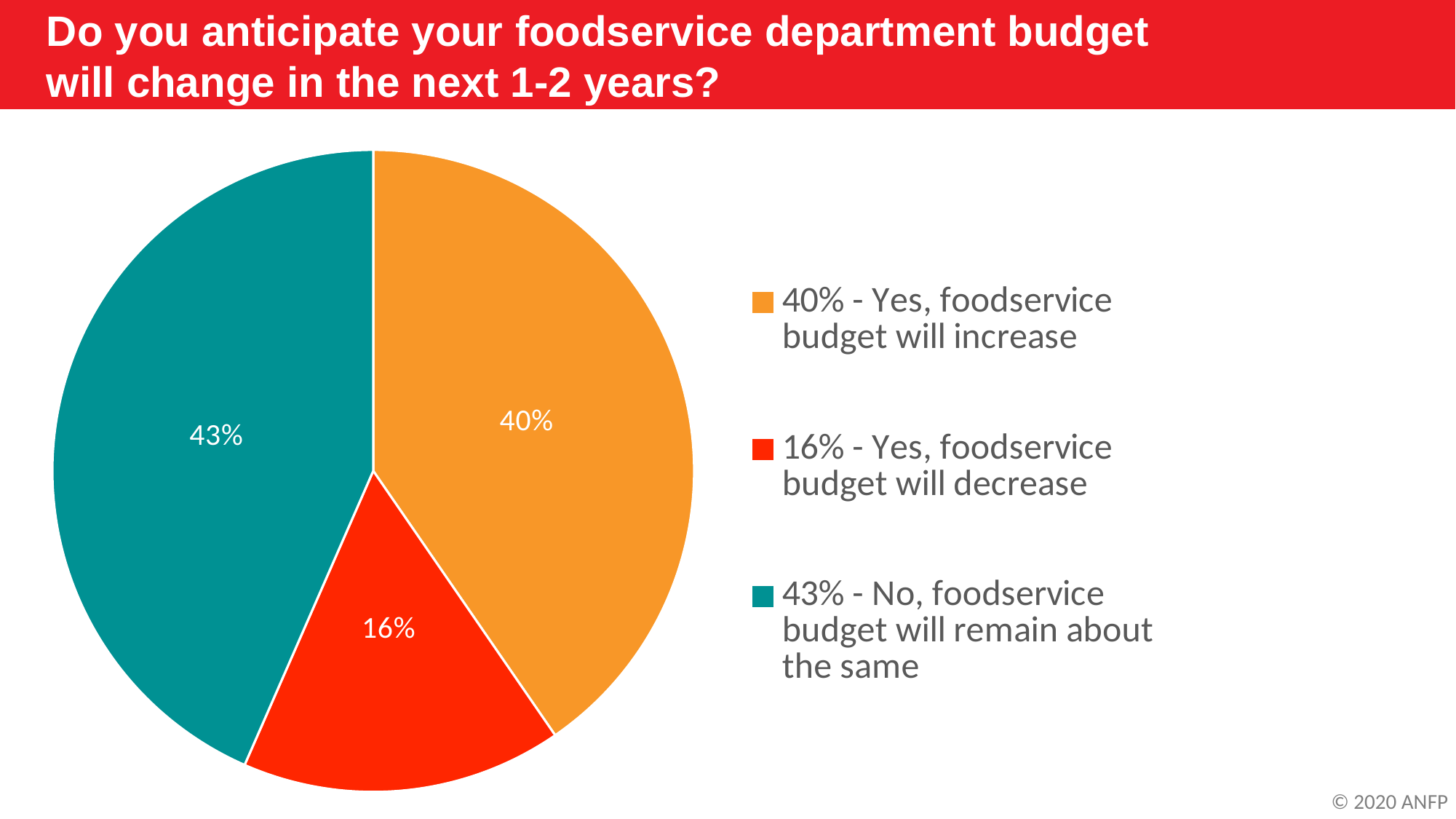
What kind of chart is shown on the slide? pie chart How many slices does the pie chart have? 3 What share of respondents said their foodservice budget will increase? 40% Which response has the largest slice of the pie? No, foodservice budget will remain about the same What share of respondents said their foodservice budget will remain about the same? 43% What is the difference in percentage points between the 'will increase' slice and the 'will decrease' slice? 24 What share of respondents said their foodservice budget will decrease? 16% What colour is the slice for 'Yes, foodservice budget will decrease'? red What is the difference in percentage points between the 'remain about the same' slice and the 'will increase' slice? 3 Which response has the smallest slice of the pie? Yes, foodservice budget will decrease Which is larger: the share expecting the budget to increase or the share expecting it to decrease? increase What question does the slide title ask? Do you anticipate your foodservice department budget will change in the next 1-2 years?